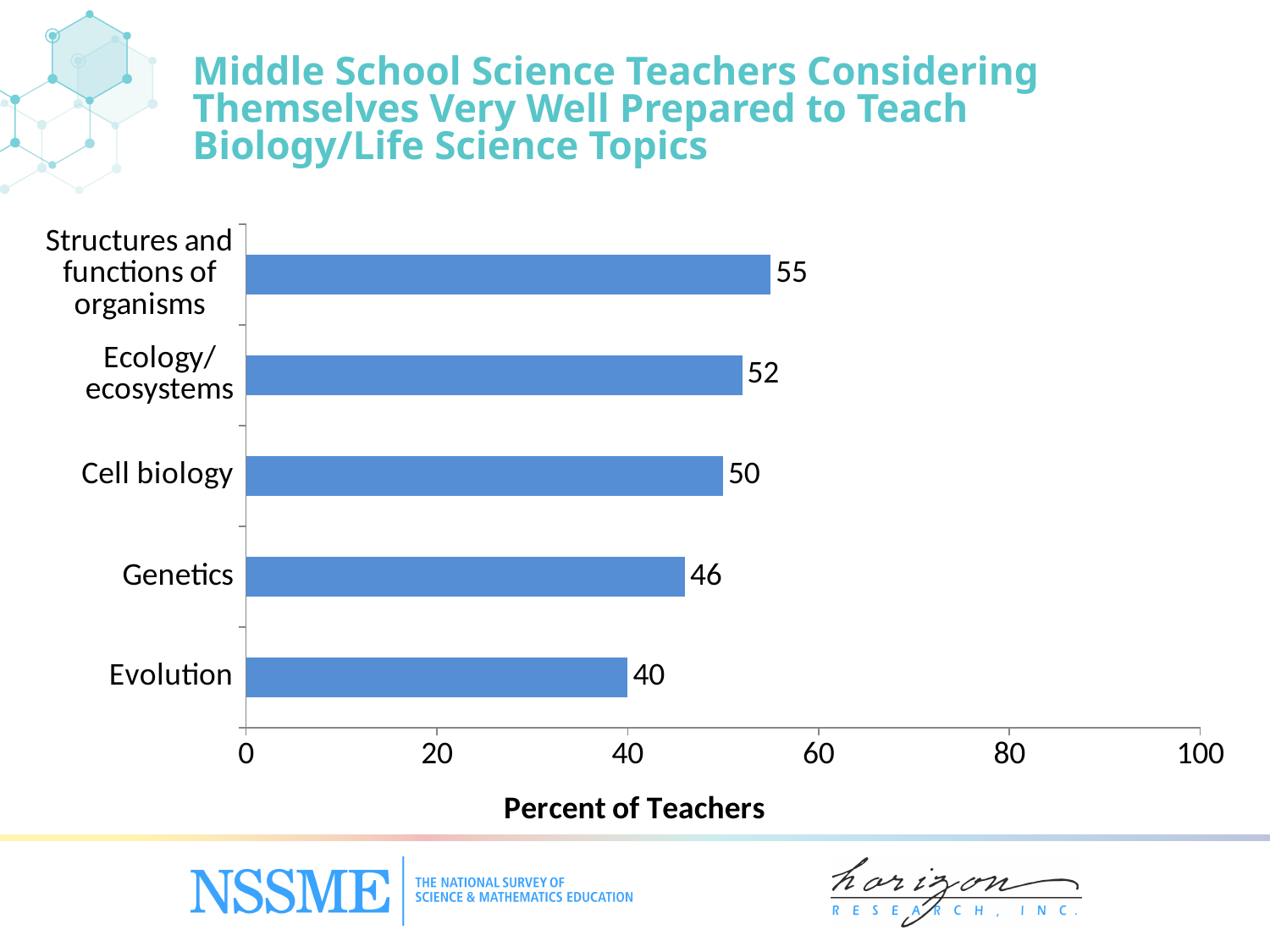
What is the value shown for Ecology/ecosystems? 52 What is the label of the horizontal axis? Percent of Teachers Which is larger, the value for Genetics or the value for Ecology/ecosystems? Ecology/ecosystems How many topics are shown in the chart? 5 What percent of teachers consider themselves very well prepared to teach Cell biology? 50 What is the difference between the values for Structures and functions of organisms and Evolution? 15 What is the value shown for Evolution? 40 What kind of chart is shown on the slide? Bar chart Is the value for Genetics greater or less than 40? greater Which topic has the highest percent of teachers? Structures and functions of organisms Which topic has the lowest percent of teachers? Evolution What is the difference between the values for Cell biology and Genetics? 4